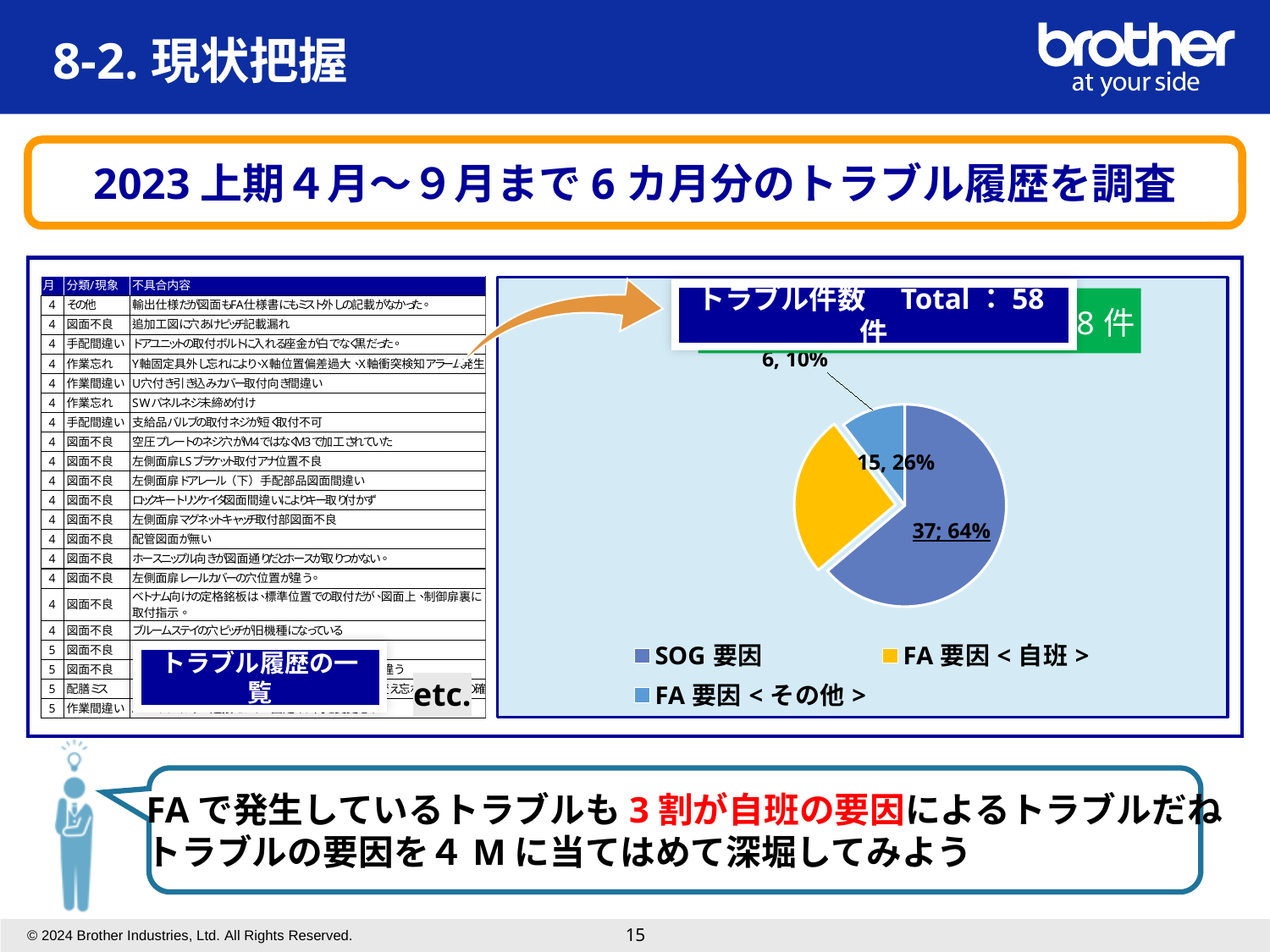
What is the count shown for SOG 要因 in the pie chart? 37 Which category has the smallest slice in the pie chart? FA 要因 <その他> Which category has the largest slice in the pie chart? SOG 要因 What percentage of the pie does FA 要因 <自班> represent? 26% What total number of troubles is stated in the pie chart's title? 58 件 What is the count shown for FA 要因 <その他> in the pie chart? 6 What percentage of the pie does SOG 要因 represent? 64% How many slices does the pie chart have? 3 What is the difference between the counts for SOG 要因 and FA 要因 <自班>? 22 What kind of chart is shown on the slide? pie chart What is the count shown for FA 要因 <自班> in the pie chart? 15 How many entries does the legend of the pie chart list? 3